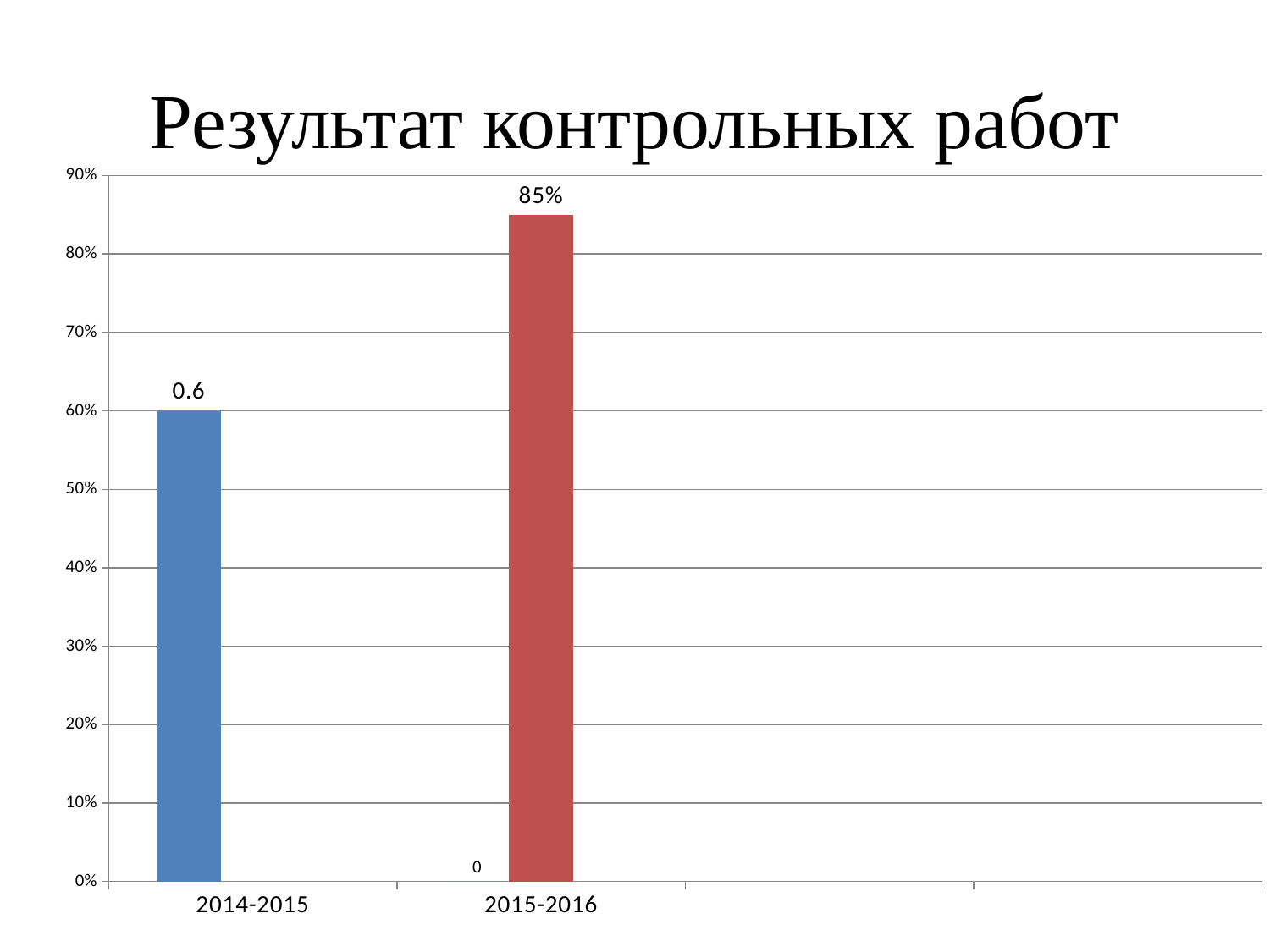
Which category has the highest bar? 2015-2016 Which category has the lowest bar? 2014-2015 What is the data label shown above the bar for 2015-2016? 85% Which is larger, the value for 2014-2015 or the value for 2015-2016? 2015-2016 Do the values rise or fall from 2014-2015 to 2015-2016? rise What colour is the bar for 2015-2016? red What is the title of the chart? Результат контрольных работ What is the data label shown above the bar for 2014-2015? 0.6 How many categories are shown on the x axis? 2 Is the value for 2014-2015 greater or less than 50%? greater What type of chart is shown on the slide? bar chart Is the value for 2015-2016 greater or less than 80%? greater